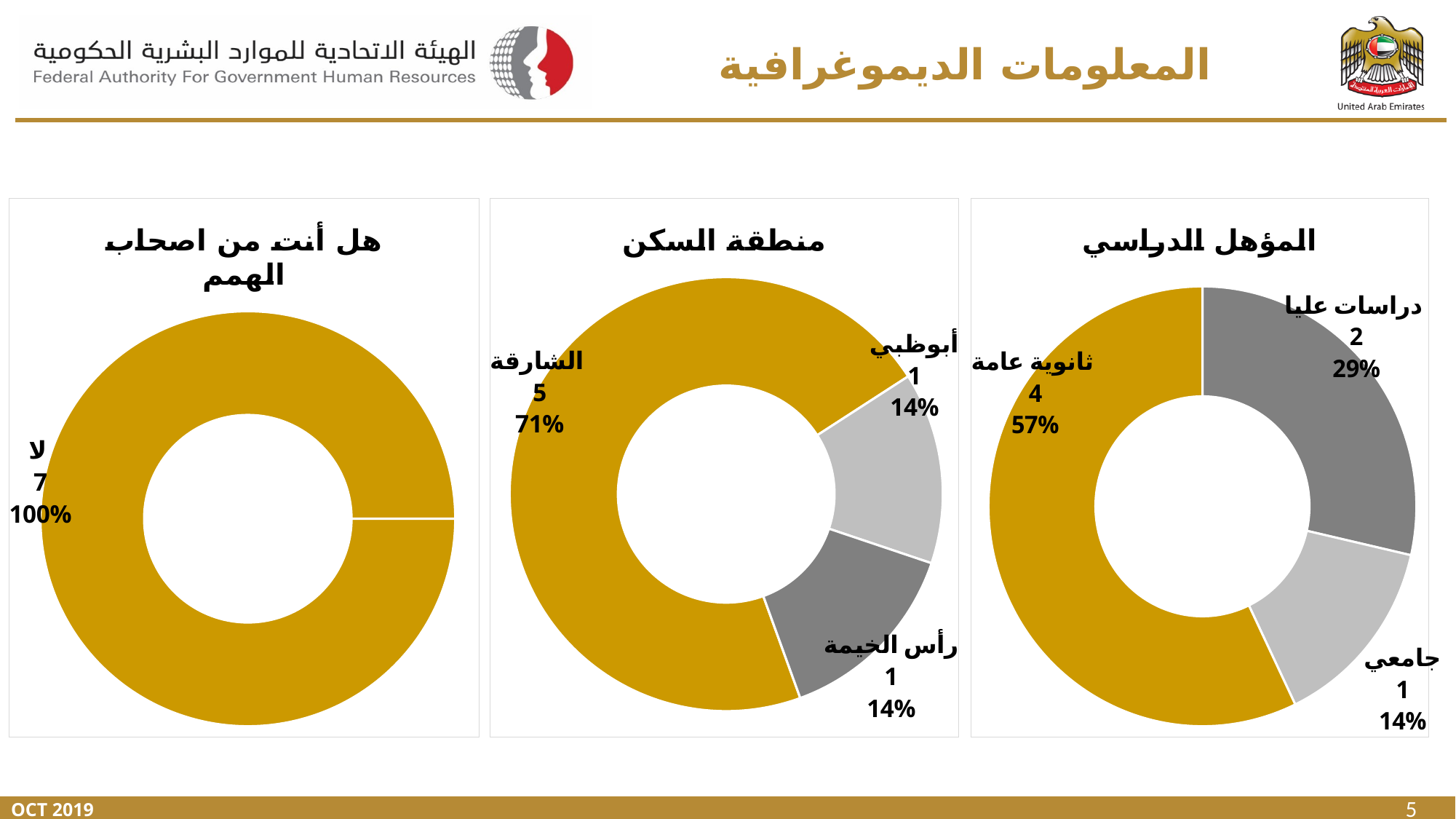
In the middle chart "منطقة السكن", what is the difference between the values for الشارقة and أبوظبي? 4 In the right chart "المؤهل الدراسي", which category has the lowest value? جامعي In the middle chart "منطقة السكن", which category has the highest value? الشارقة In the right chart "المؤهل الدراسي", what is the value for ثانوية عامة? 4 In the right chart "المؤهل الدراسي", which is larger: ثانوية عامة or دراسات عليا? ثانوية عامة How many categories are shown in the middle chart "منطقة السكن"? 3 In the left chart "هل أنت من اصحاب الهمم", what percentage share does لا have? 100% In the middle chart "منطقة السكن", what percentage share does الشارقة have? 71% What kind of chart is the middle chart titled "منطقة السكن"? Doughnut chart In the right chart "المؤهل الدراسي", what percentage share does دراسات عليا have? 29% In the left chart "هل أنت من اصحاب الهمم", what is the value for لا? 7 In the middle chart "منطقة السكن", what is the value for الشارقة? 5